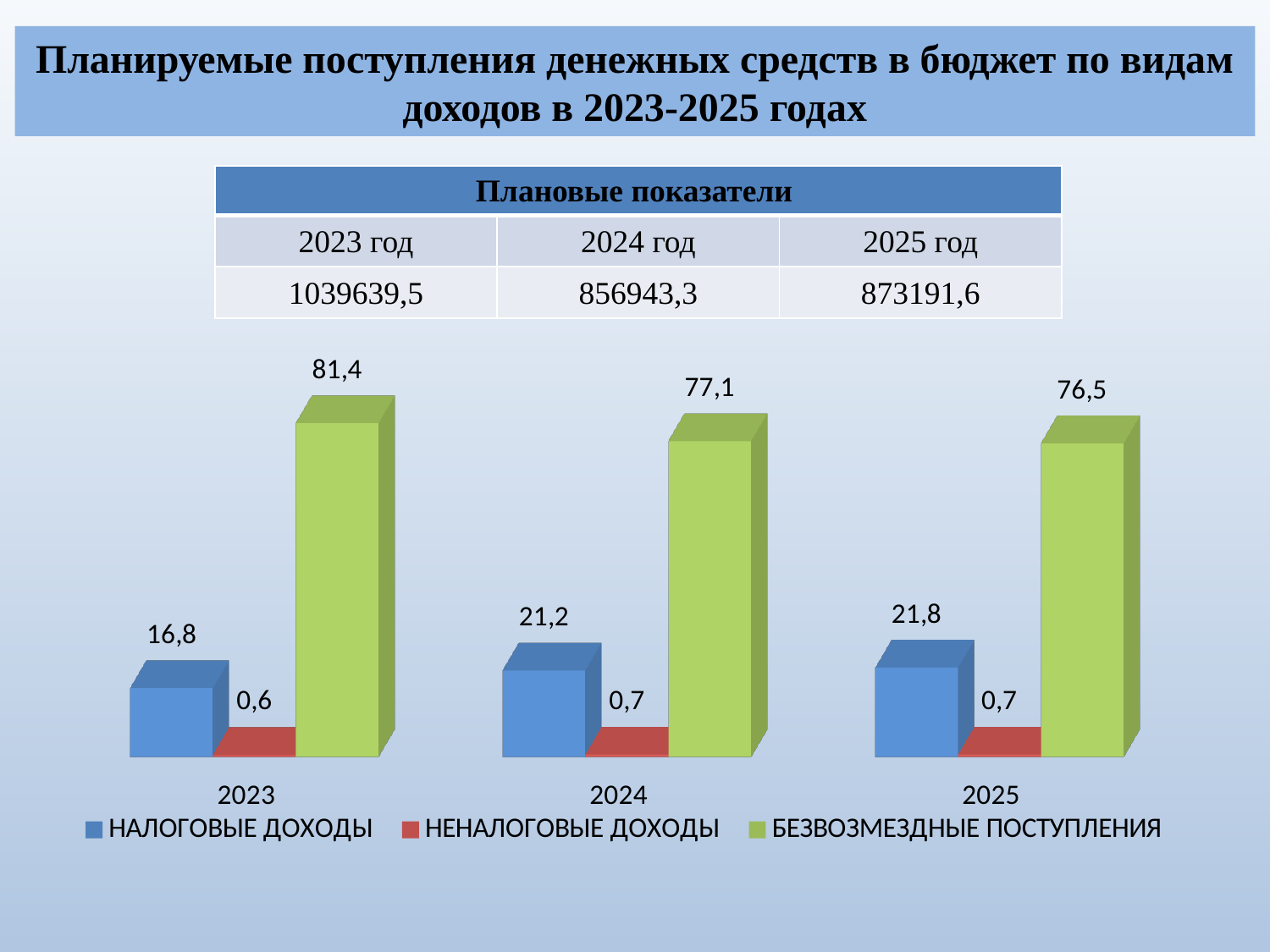
How many series does the chart legend list? 3 By how much does НАЛОГОВЫЕ ДОХОДЫ in 2025 exceed НАЛОГОВЫЕ ДОХОДЫ in 2024? 0,6 How many years (categories) are shown on the x axis of the chart? 3 What type of chart is shown on the slide? Bar chart In which year is БЕЗВОЗМЕЗДНЫЕ ПОСТУПЛЕНИЯ highest? 2023 What is the value of БЕЗВОЗМЕЗДНЫЕ ПОСТУПЛЕНИЯ for 2024? 77,1 What is the value of НЕНАЛОГОВЫЕ ДОХОДЫ for 2025? 0,7 In which year is НАЛОГОВЫЕ ДОХОДЫ lowest? 2023 What is the value of НАЛОГОВЫЕ ДОХОДЫ for 2023? 16,8 What is the difference between БЕЗВОЗМЕЗДНЫЕ ПОСТУПЛЕНИЯ and НАЛОГОВЫЕ ДОХОДЫ in 2023? 64,6 Which is larger: БЕЗВОЗМЕЗДНЫЕ ПОСТУПЛЕНИЯ in 2024 or in 2025? 2024 Do the values of БЕЗВОЗМЕЗДНЫЕ ПОСТУПЛЕНИЯ rise or fall from 2023 to 2025? Fall